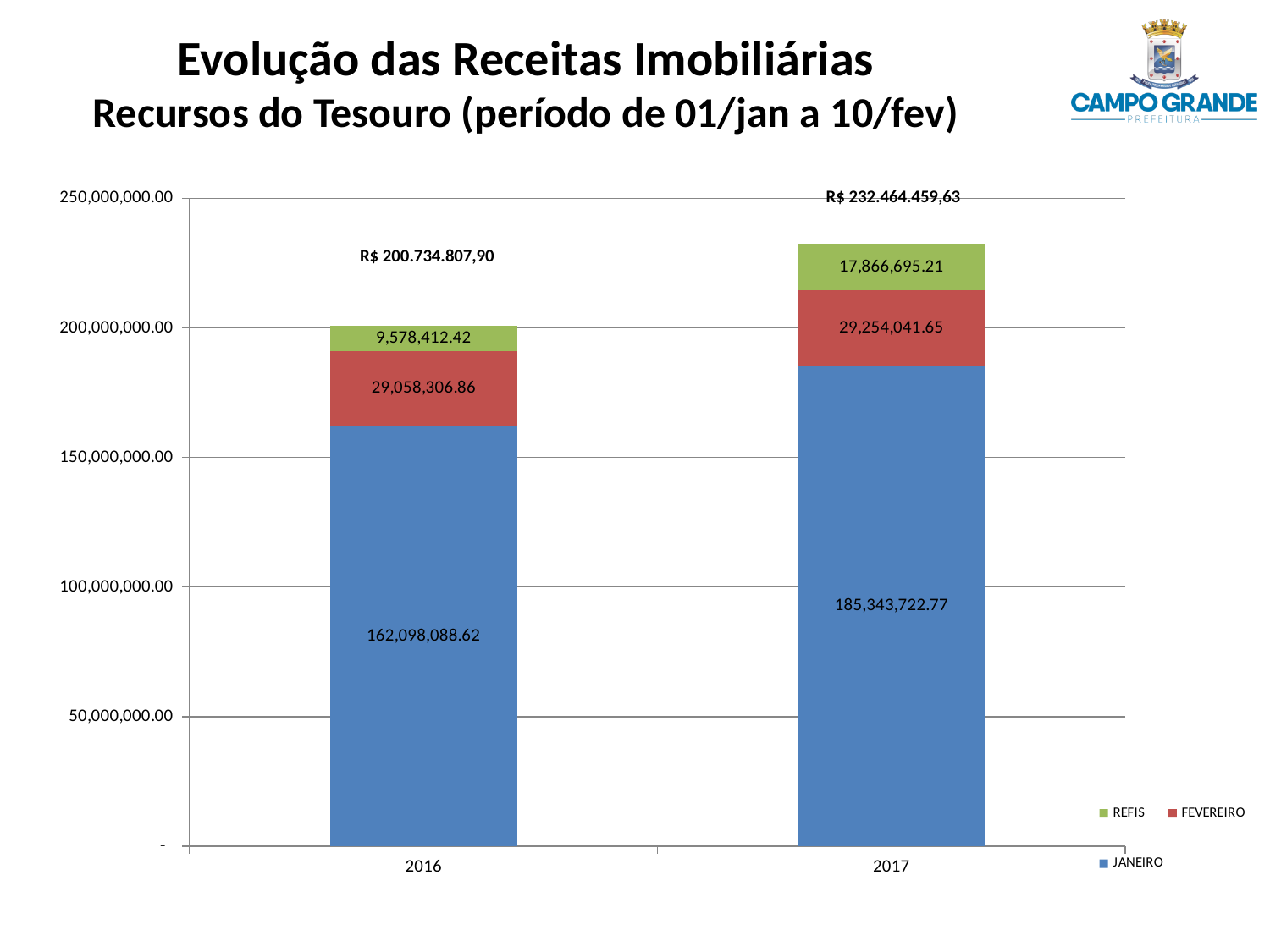
What kind of chart is shown on the slide? Stacked bar chart What is the value of REFIS for 2017? 17,866,695.21 What is the total shown above the 2017 stacked bar? R$ 232.464.459,63 What is the value of FEVEREIRO for 2016? 29,058,306.86 What is the difference between the JANEIRO value for 2017 and the JANEIRO value for 2016? 23,245,634.15 How many years are shown on the x axis? 2 What is the total shown above the 2016 stacked bar? R$ 200.734.807,90 What is the value of JANEIRO for 2016? 162,098,088.62 What is the difference between the REFIS value for 2017 and the REFIS value for 2016? 8,288,282.79 Is the JANEIRO value for 2017 greater or less than 150,000,000.00? greater Which year has the larger JANEIRO value, 2016 or 2017? 2017 How many series does the legend list? 3